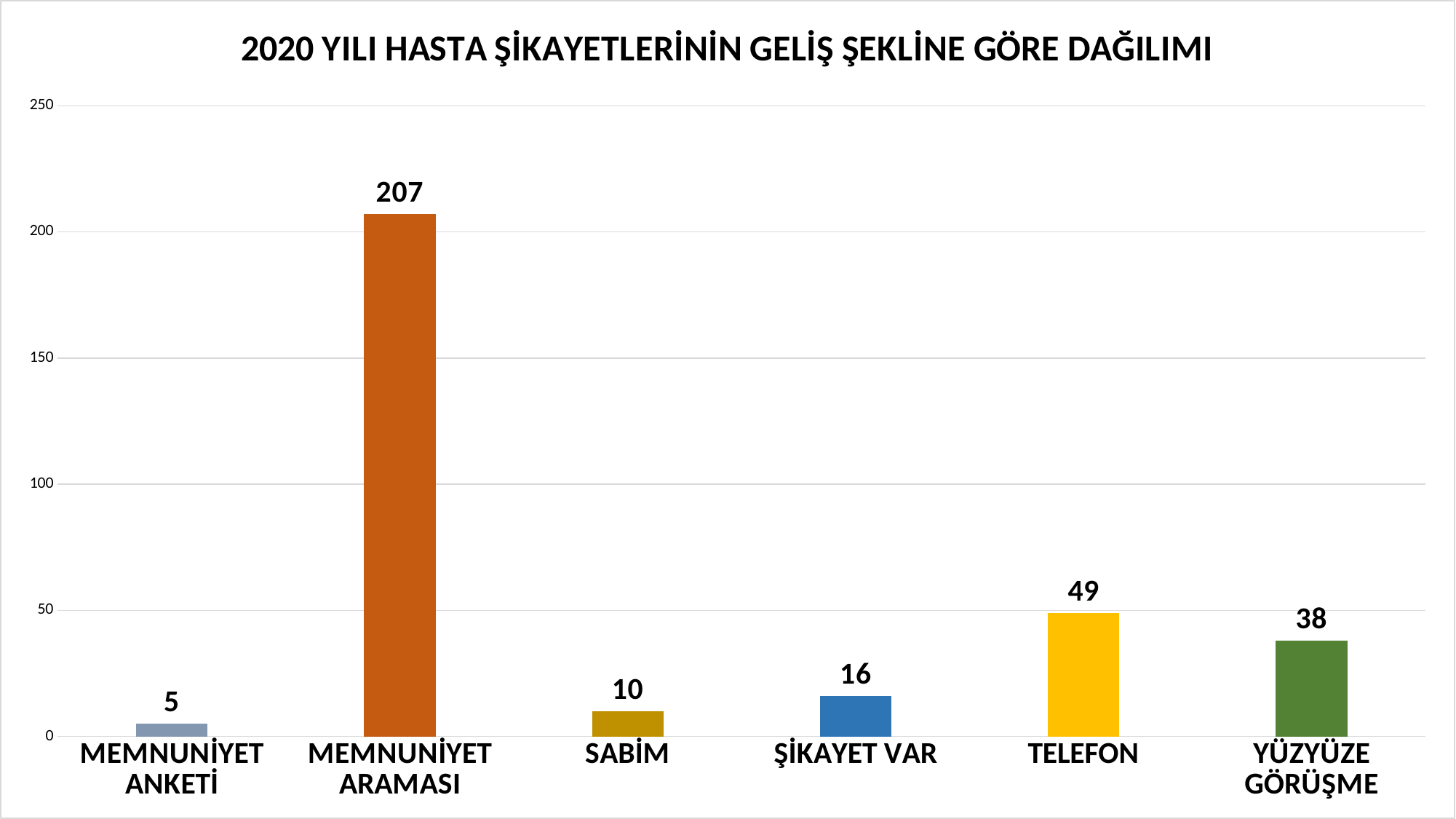
What is the difference between the values for MEMNUNİYET ARAMASI and TELEFON? 158 Which is larger, the value for ŞİKAYET VAR or the value for SABİM? ŞİKAYET VAR What is the value for SABİM? 10 What is the difference between the values for TELEFON and YÜZYÜZE GÖRÜŞME? 11 Is the value for MEMNUNİYET ARAMASI greater or less than 200? greater What is the value for YÜZYÜZE GÖRÜŞME? 38 Which category has the highest value? MEMNUNİYET ARAMASI What is the value for TELEFON? 49 What is the value for MEMNUNİYET ARAMASI? 207 How many categories are shown on the x axis? 6 What kind of chart is shown on the slide? bar chart Which category has the lowest value? MEMNUNİYET ANKETİ